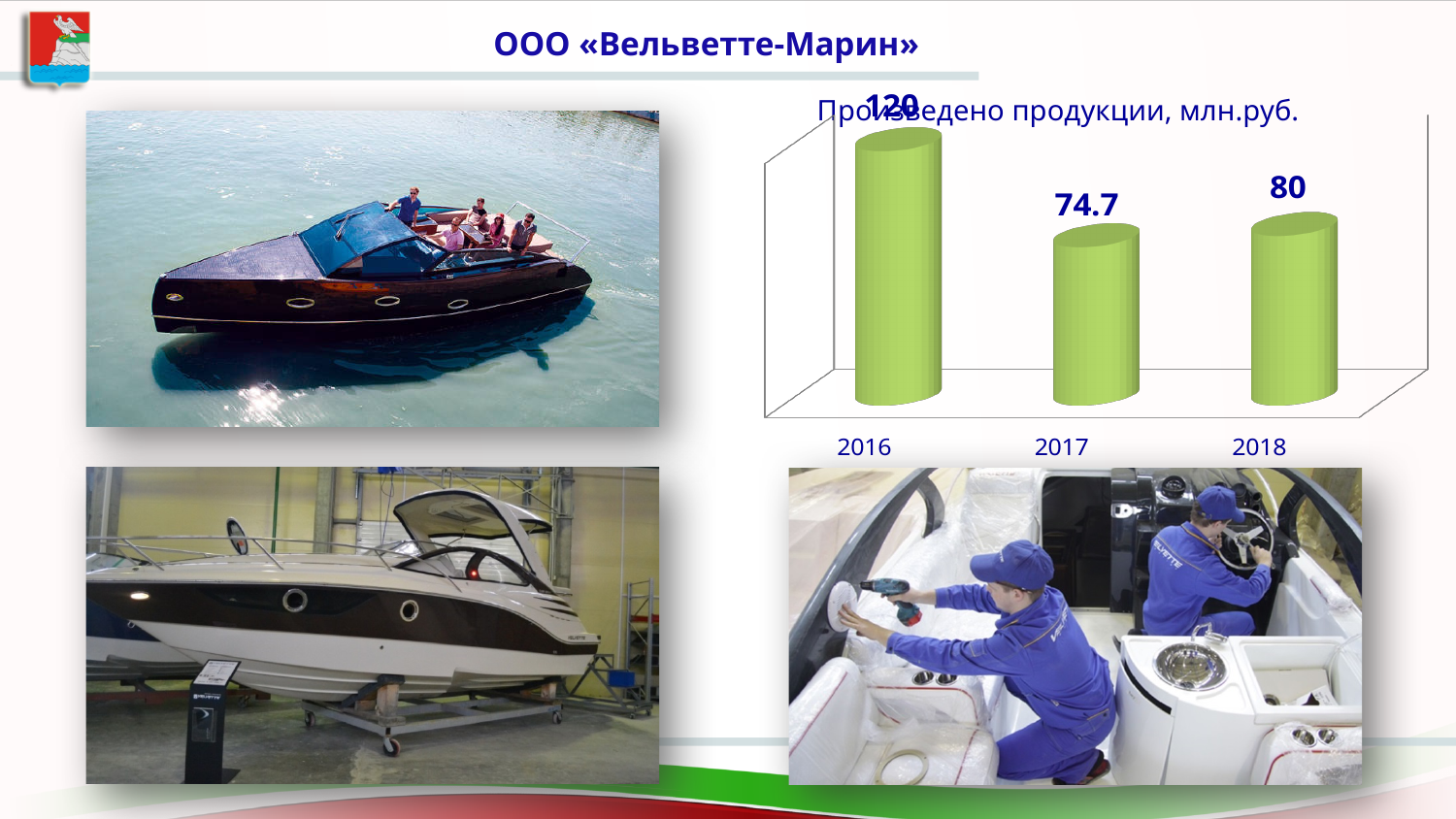
What is the difference between the values for 2018 and 2017? 5.3 Which year has the highest value in the chart? 2016 Does the value fall or rise from 2016 to 2017? fall What is the title of the chart? Произведено продукции, млн.руб. Which is larger, the value for 2017 or the value for 2018? 2018 How many years are shown in the chart? 3 What is the difference between the values for 2016 and 2018? 40 Which year has the lowest value in the chart? 2017 What kind of chart is shown on the slide? bar chart What is the value for 2017 in the chart? 74.7 What is the value for 2016 in the chart? 120 What is the value for 2018 in the chart? 80